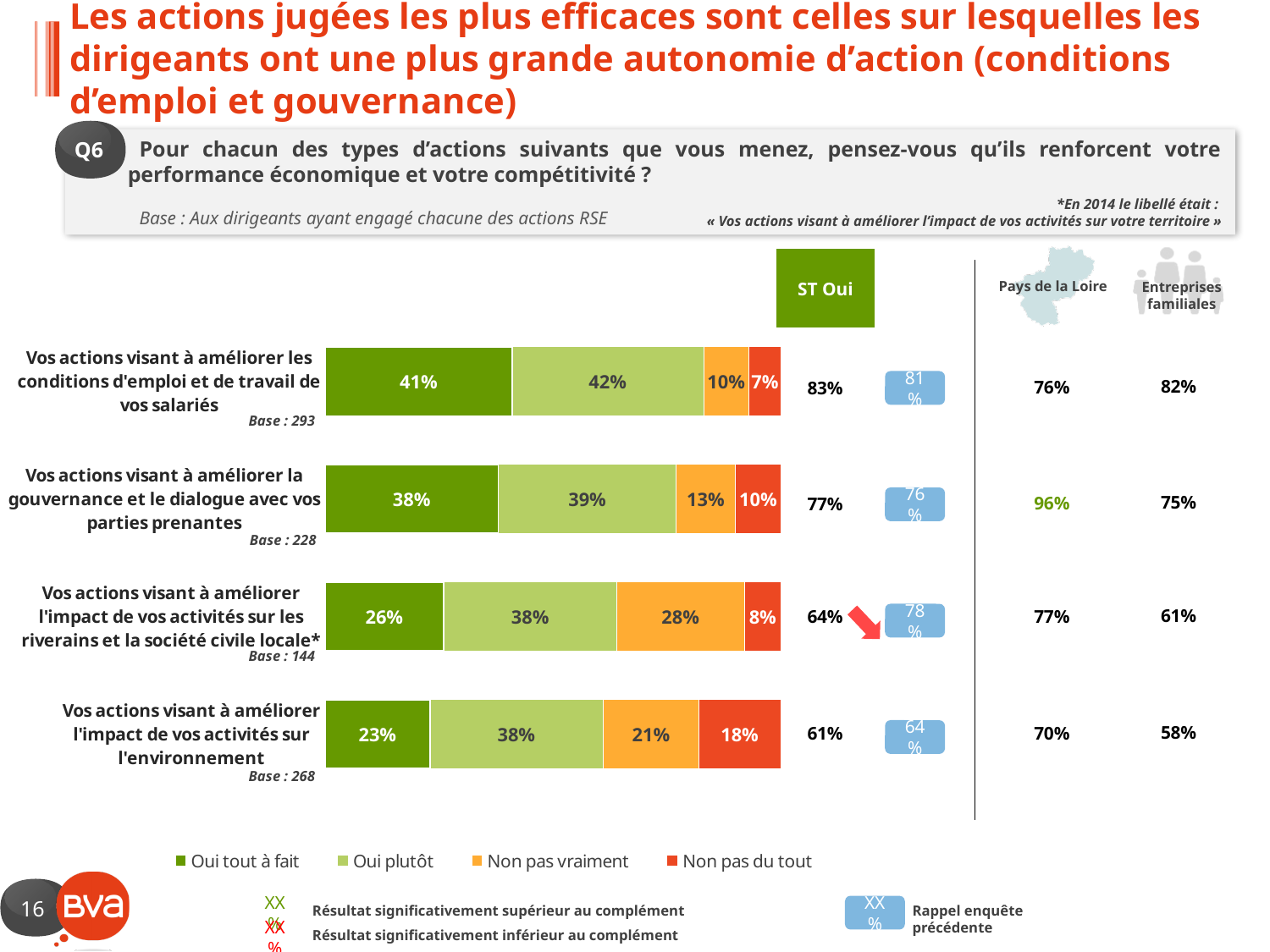
What is the combined 'Oui tout à fait' plus 'Oui plutôt' total (ST Oui) for actions on the impact on local residents and civil society? 64% How many types of actions (categories) are shown in the chart? 4 What is the 'Oui tout à fait' value for actions aimed at improving employees' working and employment conditions? 41% What is the 'Non pas vraiment' value for actions aimed at improving the impact of activities on local residents and civil society? 28% What colour represents the 'Non pas vraiment' series in the legend? Orange What type of chart is used to show the responses to Q6? Stacked bar chart Which action has the lowest 'Oui tout à fait' share? Vos actions visant à améliorer l'impact de vos activités sur l'environnement What is the difference between the 'Oui plutôt' value and the 'Oui tout à fait' value for actions on governance and dialogue with stakeholders? 1% Which action has the highest 'Oui tout à fait' share? Vos actions visant à améliorer les conditions d'emploi et de travail de vos salariés What is the 'Non pas du tout' value for actions aimed at improving the impact of activities on the environment? 18% How many series does the legend list? 4 Which is larger: the 'Non pas du tout' value for governance actions or for environmental actions? Environmental actions (18%)